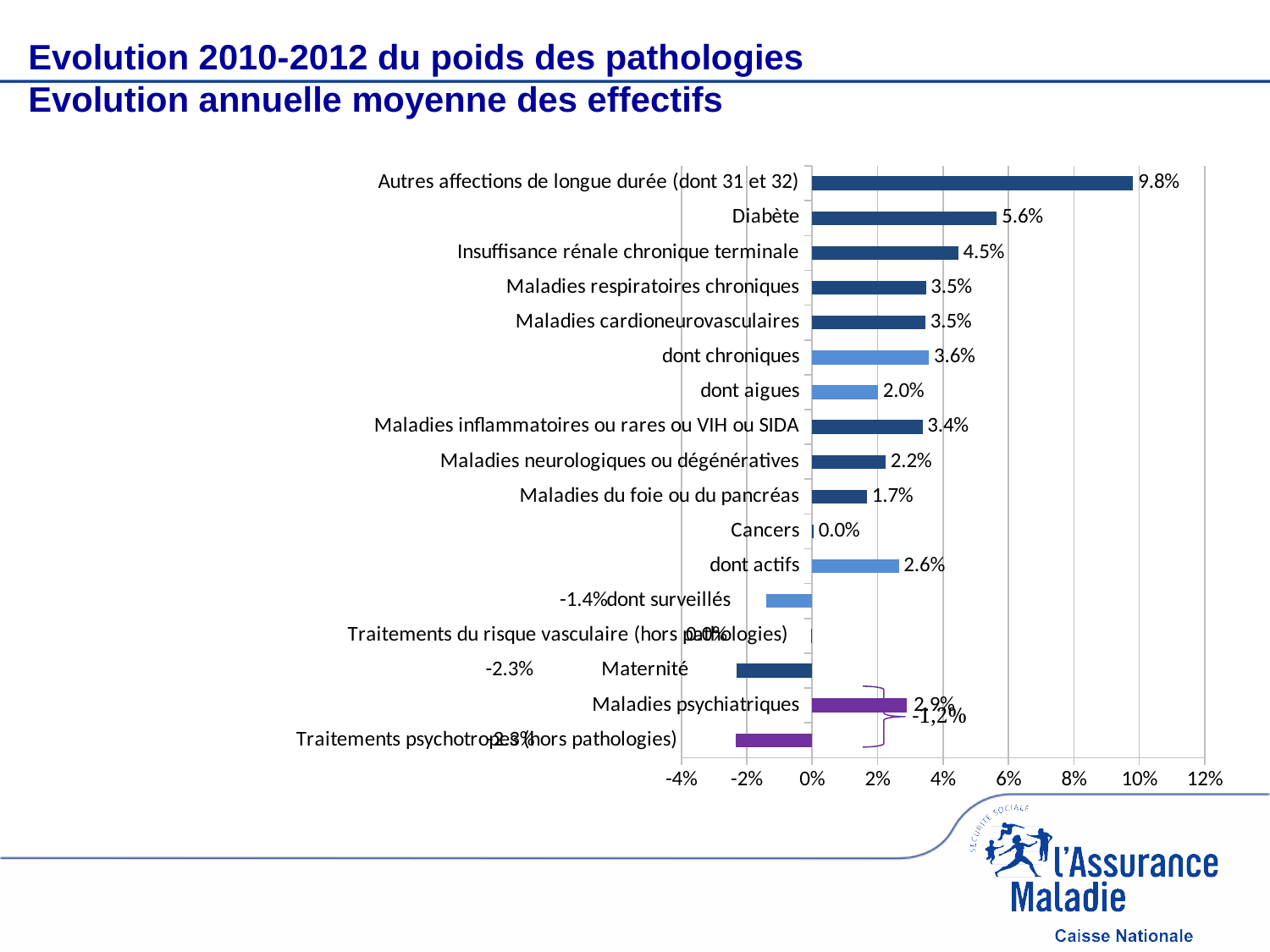
Is the value for Maladies psychiatriques greater or less than 2%? greater What is the value for Maternité? -2.3% What is the value for dont surveillés? -1.4% What is the value for Insuffisance rénale chronique terminale? 4.5% What is the value for Cancers? 0.0% What is the value for Autres affections de longue durée (dont 31 et 32)? 9.8% What is the value for Diabète? 5.6% Which category has the highest value? Autres affections de longue durée (dont 31 et 32) Which is larger, the value for dont chroniques or the value for dont aigues? dont chroniques What kind of chart is shown on the slide? bar chart What is the difference between the values for Diabète and Insuffisance rénale chronique terminale? 1.1% How many categories are shown on the chart? 17